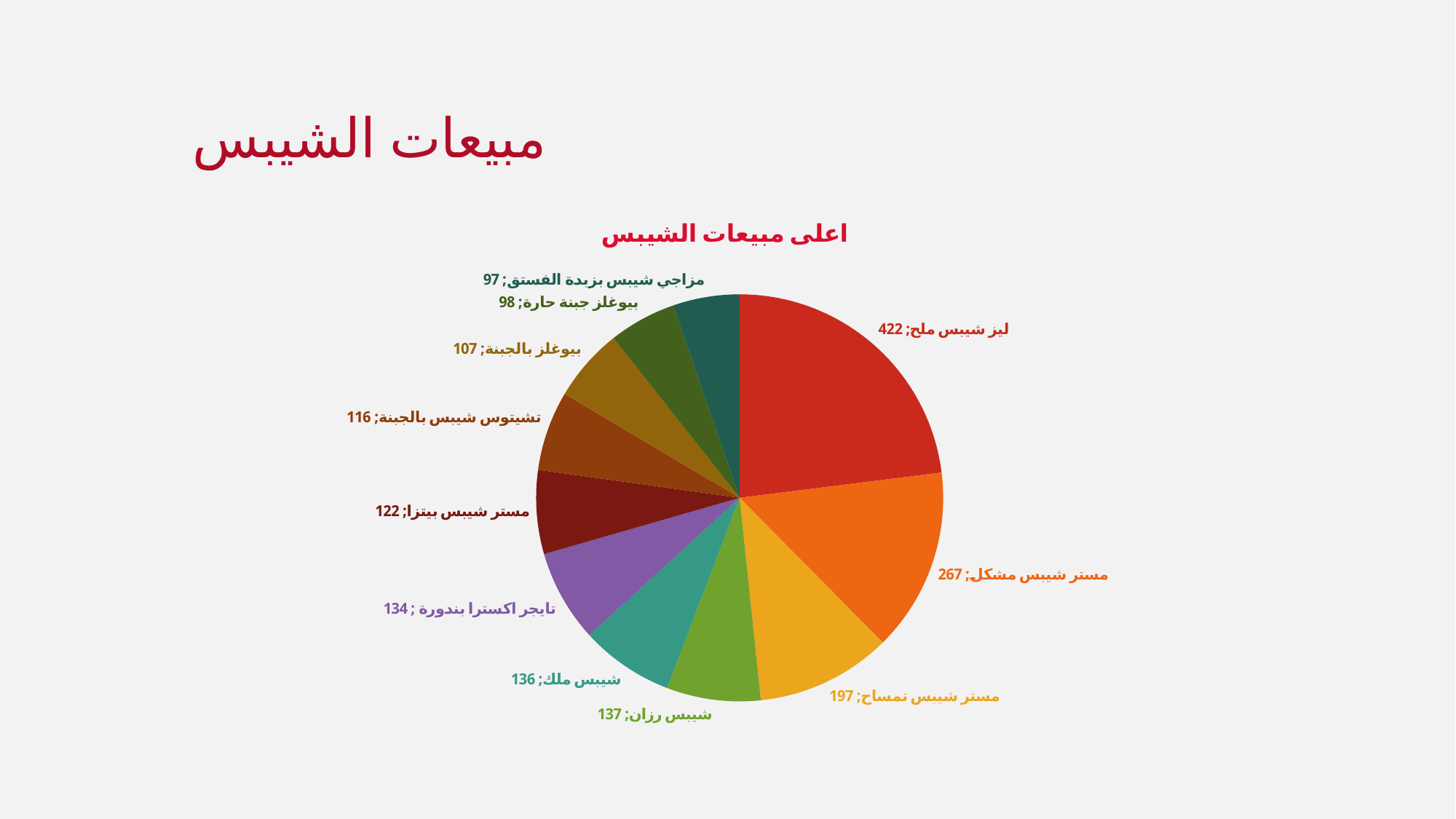
Which category has the largest slice? ليز شيبس ملح What is the title of the chart? اعلى مبيعات الشيبس What is the value for ليز شيبس ملح? 422 What is the difference between the values for مستر شيبس تمساح and مستر شيبس بيتزا? 75 Which category has the smallest slice? مزاجي شيبس بزبدة الفستق What type of chart is shown on the slide? Pie chart Which is larger, مستر شيبس مشكل or مستر شيبس تمساح? مستر شيبس مشكل What is the value for بيوغلز بالجبنة? 107 What is the difference between the values for ليز شيبس ملح and مستر شيبس مشكل? 155 How many slices does the pie chart have? 11 What is the value for مستر شيبس تمساح? 197 What is the value for تايجر اكسترا بندورة? 134